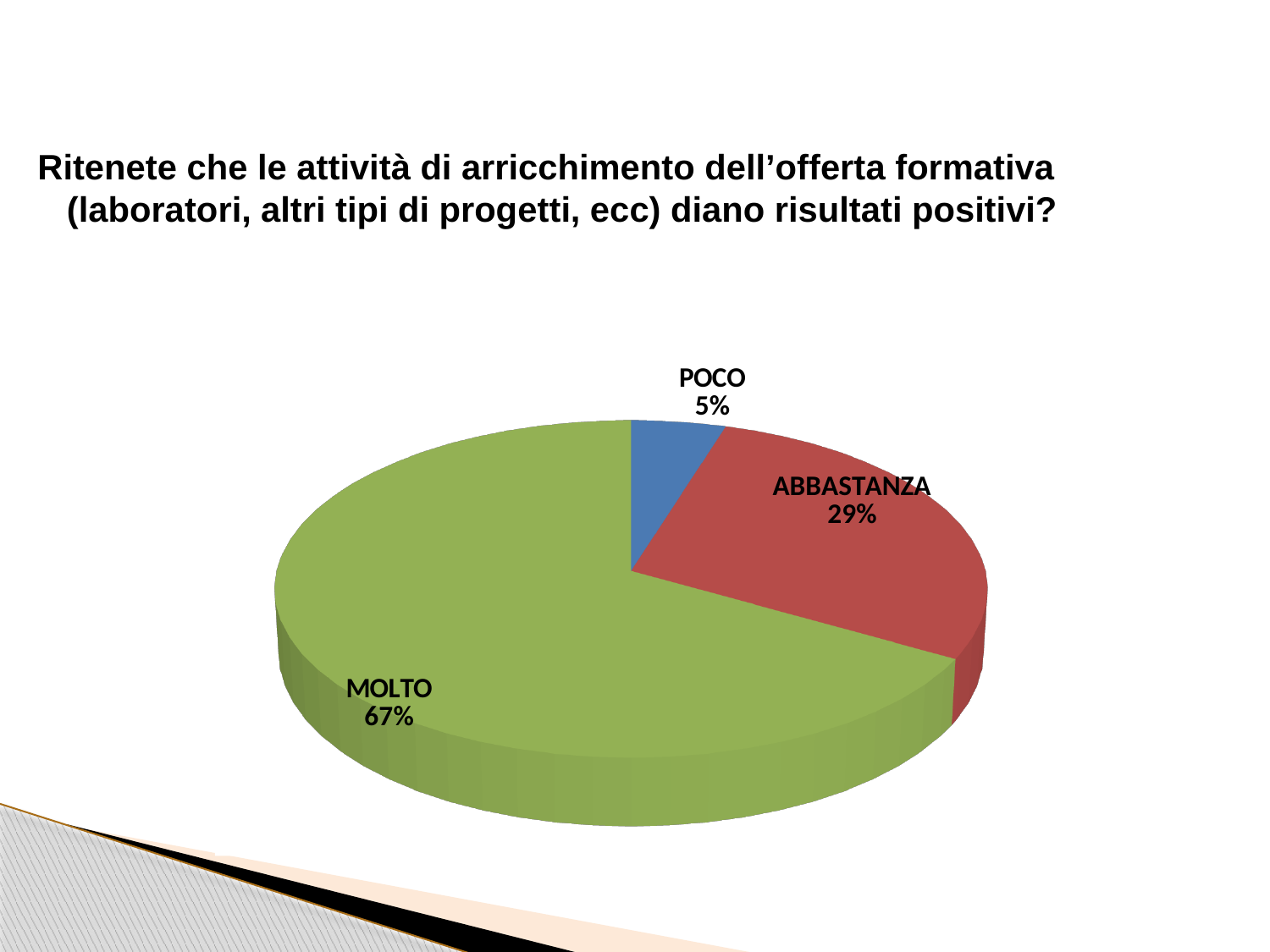
What kind of chart is shown on the slide? pie chart How many categories are shown in the pie chart? 3 What share of the pie does MOLTO represent? 67% What colour is the POCO slice? blue Which is larger, the share for ABBASTANZA or the share for POCO? ABBASTANZA What share of the pie does POCO represent? 5% What is the difference in percentage points between MOLTO and ABBASTANZA? 38 What share of the pie does ABBASTANZA represent? 29% What is the difference in percentage points between ABBASTANZA and POCO? 24 Which category has the smallest slice of the pie? POCO What colour is the MOLTO slice? green Which category has the largest slice of the pie? MOLTO